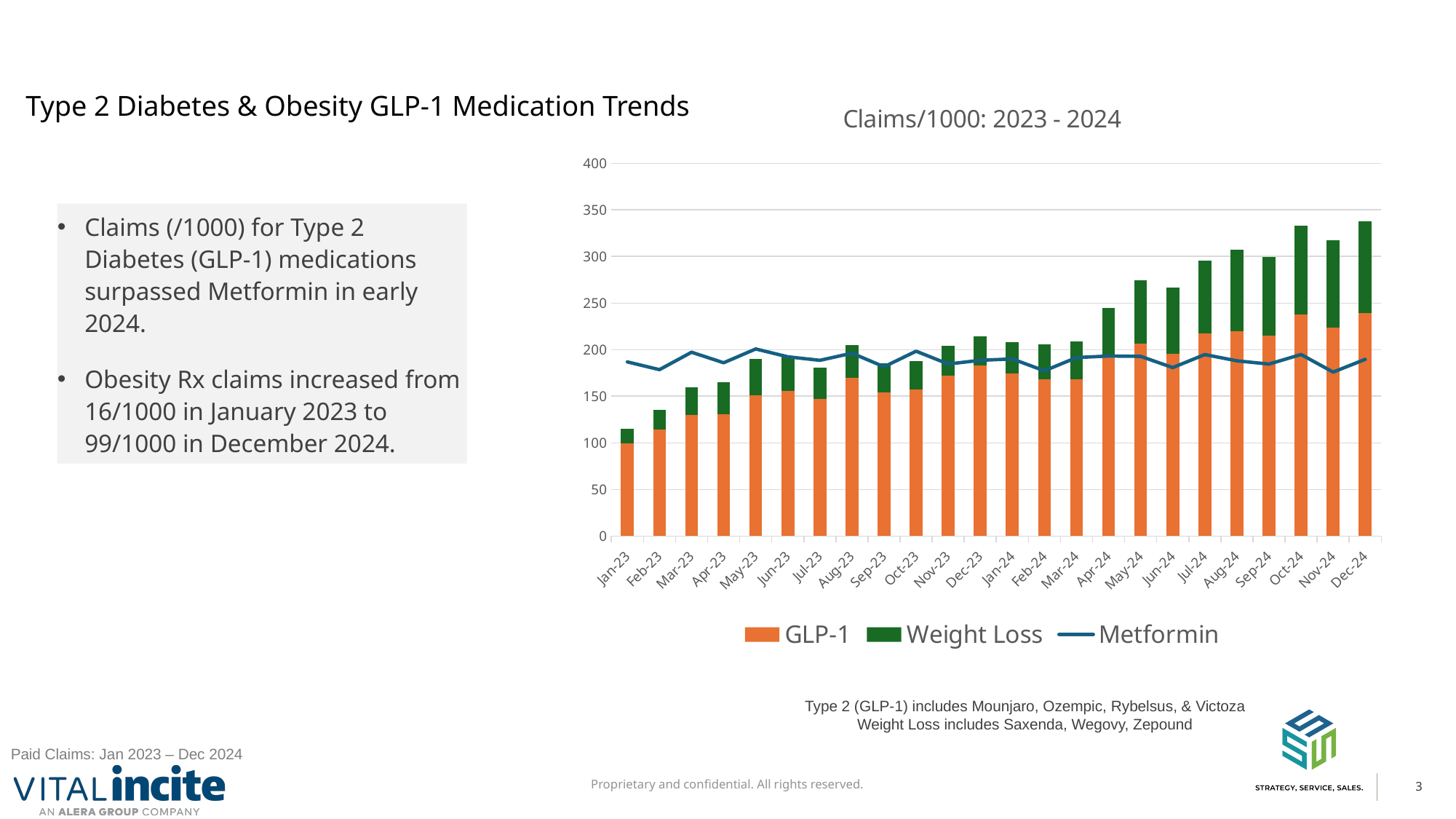
Do the GLP-1 bars generally rise or fall from Jan-23 to Dec-24? rise How many months are shown along the x axis of the chart? 24 What kind of chart is shown on the slide? A stacked bar chart with a line Which series is shown in green in the chart? Weight Loss Is the Metformin value for Jan-23 greater or less than 200? less In Dec-24, which is larger: the GLP-1 bar or the Metformin line value? GLP-1 Is the total stacked bar for Jul-23 greater or less than 200? less What is the title of the chart? Claims/1000: 2023 - 2024 How many series does the chart legend list? 3 Is the total stacked bar for Oct-24 greater or less than 300? greater Which month has the lowest total stacked bar in the chart? Jan-23